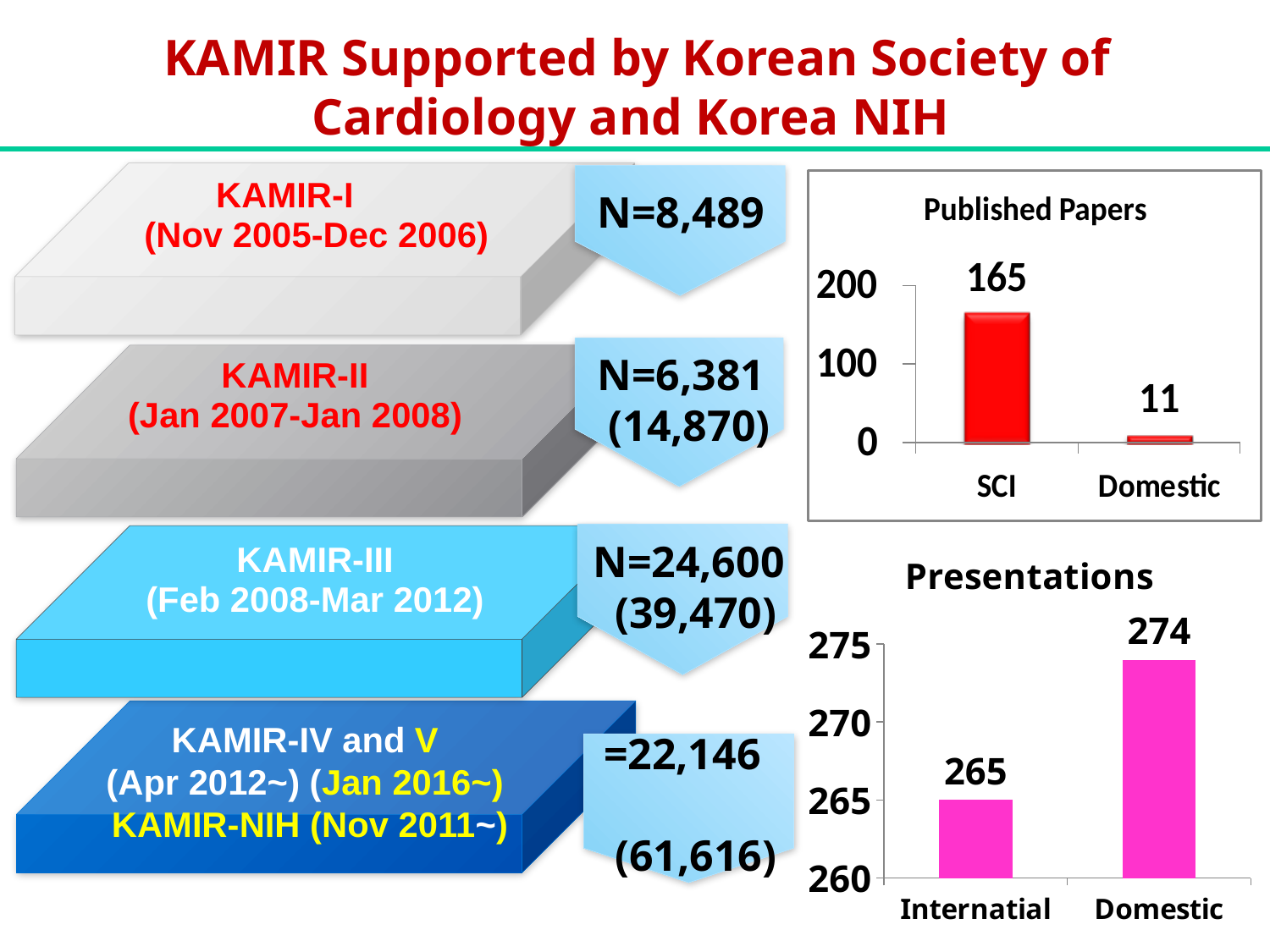
In the Published Papers chart, is the value for SCI greater or less than 100? greater In the Presentations chart, is the value for Domestic greater or less than 270? greater In the Presentations chart, which category has the lower value? Internatial In the Presentations chart, what is the difference between the Domestic and Internatial values? 9 In the Published Papers chart, how many Domestic papers are shown? 11 In the Published Papers chart, what is the difference between the SCI and Domestic values? 154 How many categories does the Presentations chart show? 2 In the Published Papers chart, which category has the higher value? SCI In the Presentations chart, what is the value for Internatial? 265 In the Published Papers chart, how many SCI papers are shown? 165 What type of chart is the Published Papers chart? bar chart In the Presentations chart, what is the value for Domestic? 274